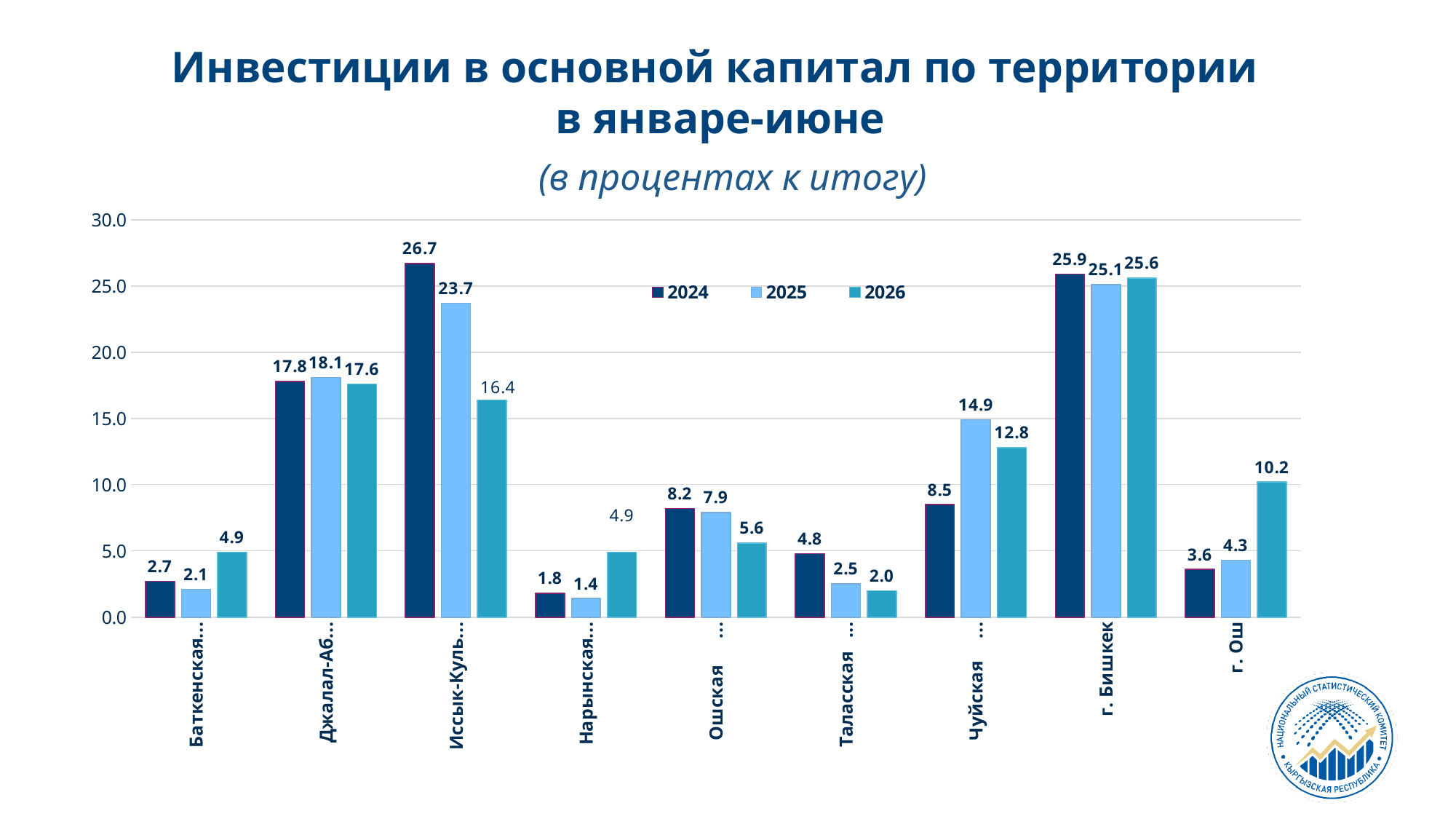
Which is larger for Таласская: the 2024 value or the 2025 value? 2024 What is the subtitle shown under the chart title? (в процентах к итогу) What is the value for Чуйская in 2025? 14.9 What type of chart is shown on the slide? bar chart How many categories (territories) are shown on the x axis? 9 Which territory has the lowest value in 2025? Нарынская What is the value for г. Бишкек in 2024? 25.9 What is the value for г. Ош in 2026? 10.2 What is the difference between the 2024 and 2026 values for Иссык-Кульская? 10.3 Which territory has the highest value in 2024? Иссык-Кульская How many series does the legend list? 3 Do the values for Ошская rise or fall from 2024 to 2026? fall